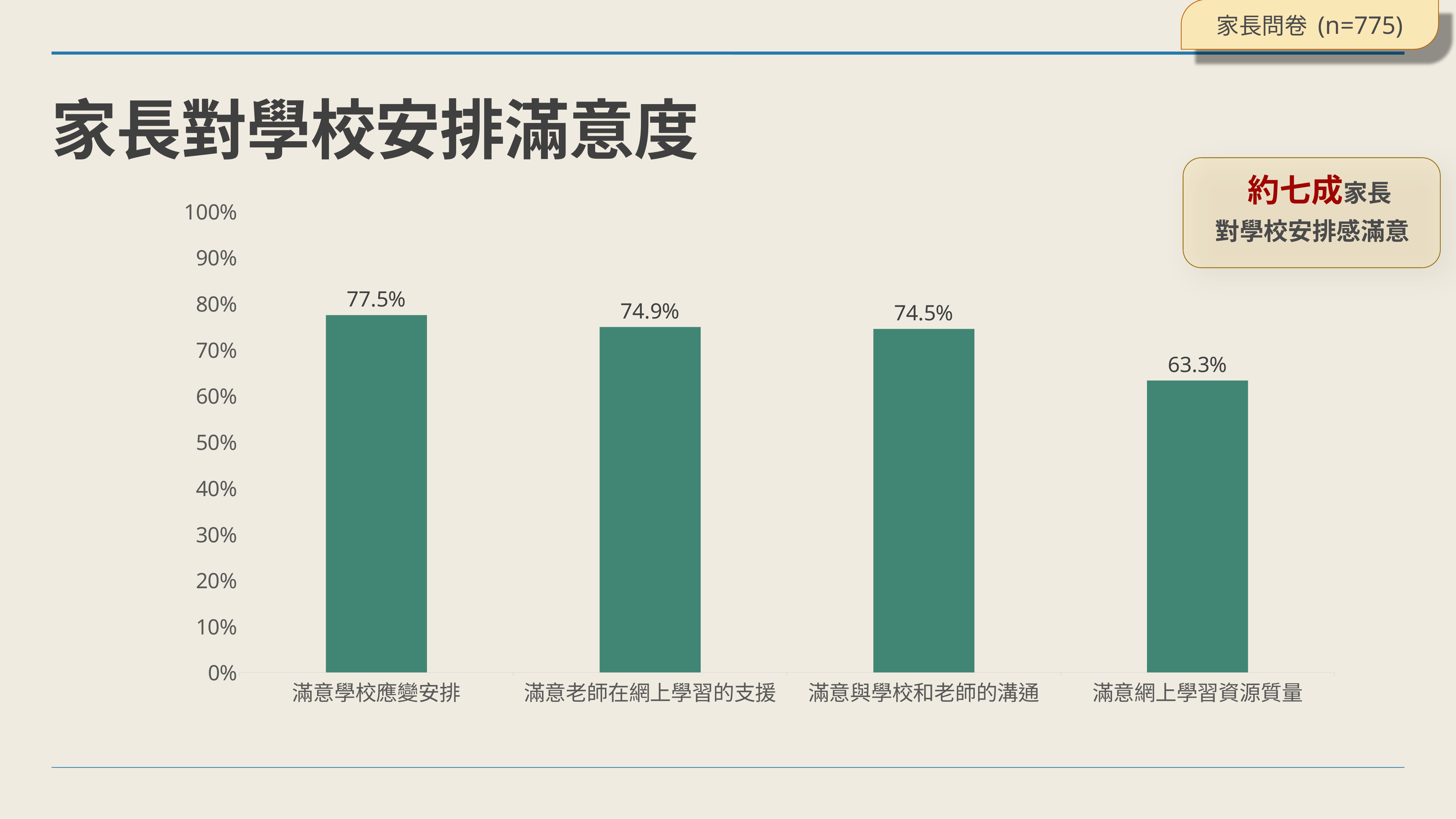
What is the value for 滿意學校應變安排? 77.5% What is the title of the slide containing the chart? 家長對學校安排滿意度 What is the value for 滿意網上學習資源質量? 63.3% Which category has the lowest value? 滿意網上學習資源質量 What is the value for 滿意與學校和老師的溝通? 74.5% What is the difference between the values for 滿意老師在網上學習的支援 and 滿意與學校和老師的溝通? 0.4% Which is larger, the value for 滿意學校應變安排 or the value for 滿意網上學習資源質量? 滿意學校應變安排 Which category has the highest value? 滿意學校應變安排 What kind of chart is shown on the slide? Bar chart What is the value for 滿意老師在網上學習的支援? 74.9% How many categories are shown in the chart? 4 What is the difference between the values for 滿意學校應變安排 and 滿意網上學習資源質量? 14.2%